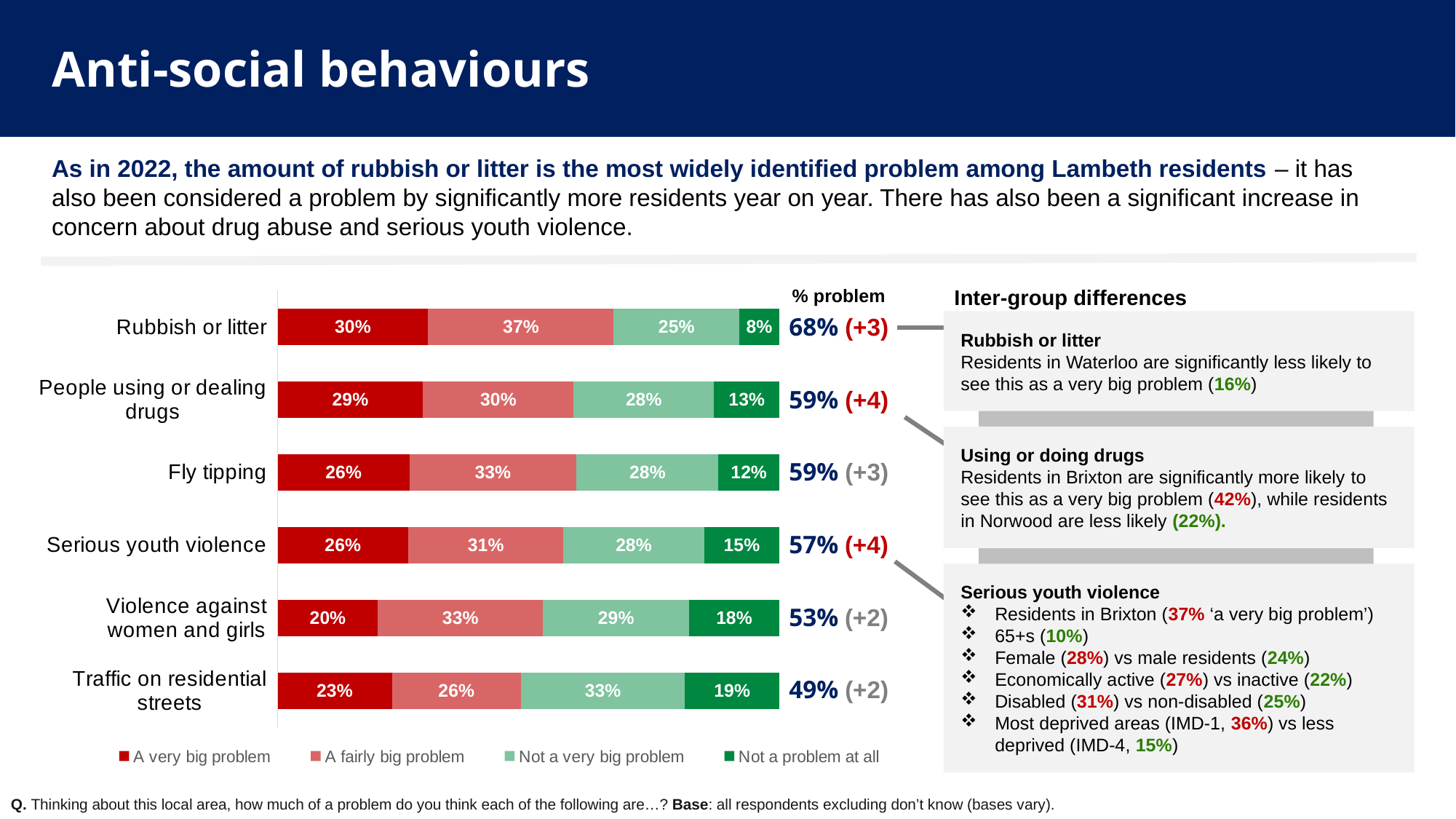
Which category has the lowest '% problem' figure? Traffic on residential streets How many categories are shown in the chart? 6 How many series does the legend list? 4 What percentage of residents say rubbish or litter is 'a very big problem'? 30% What change from the previous year is shown next to the '% problem' figure for people using or dealing drugs? +4 What is the '% problem' figure shown for fly tipping? 59% Which category has the highest '% problem' figure? Rubbish or litter What kind of chart is shown on the slide? Stacked bar chart What is the total of the 'a very big problem' and 'a fairly big problem' segments for serious youth violence? 57% What is the difference between the 'a very big problem' values for rubbish or litter and violence against women and girls? 10 percentage points What percentage of residents say traffic on residential streets is 'not a problem at all'? 19% Which is larger: the 'a fairly big problem' value for rubbish or litter or for fly tipping? Rubbish or litter